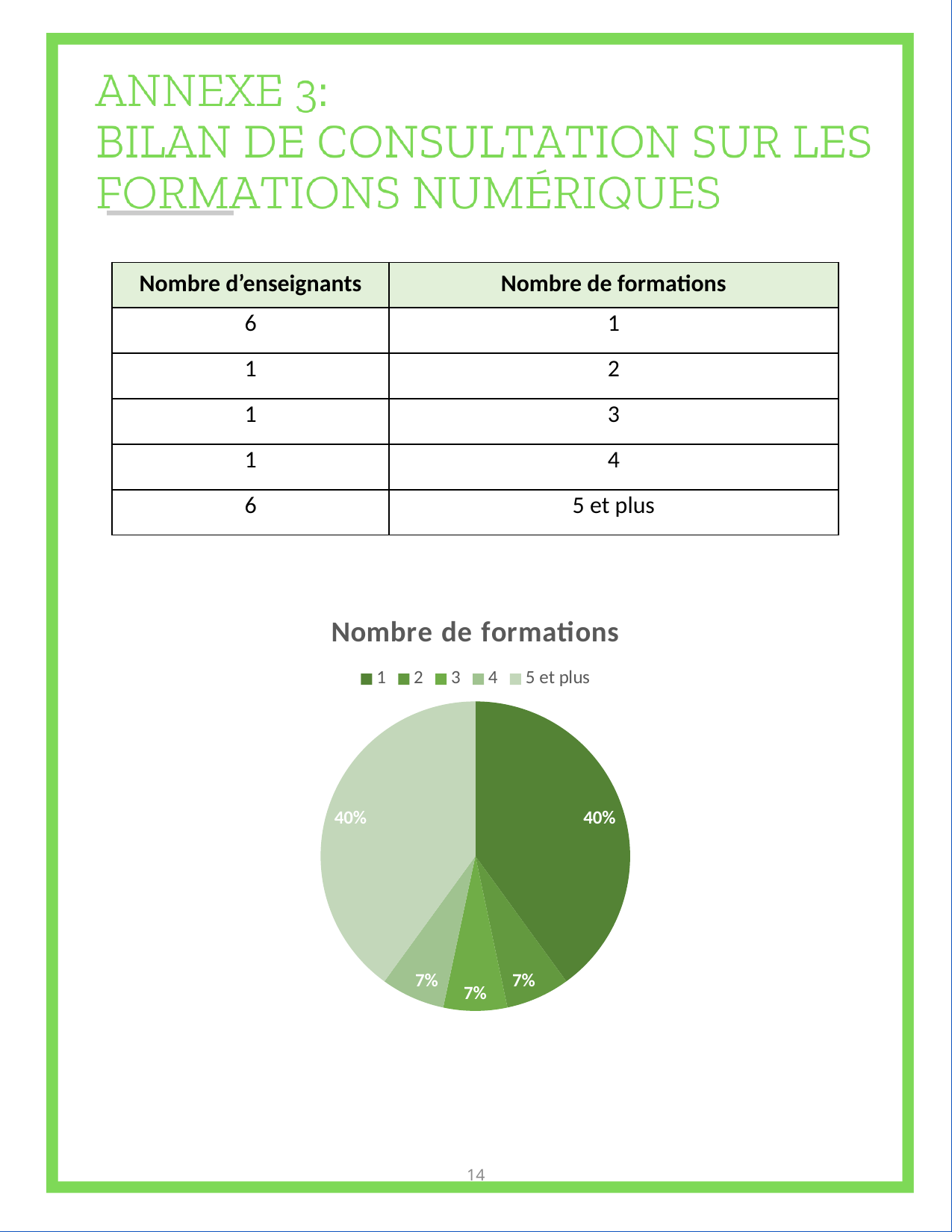
What share of the pie does the slice for "3" represent? 7% Which slice is larger, "1" or "2"? 1 What share of the pie does the slice for "2" represent? 7% What share of the pie does the slice for "1" represent? 40% What type of chart is shown on the slide? pie chart How many entries does the legend of the pie chart list? 5 How many slices does the pie chart have? 5 Which legend entry is shown in the darkest green in the pie chart? 1 What is the difference in percentage points between the slice for "5 et plus" and the slice for "4"? 33% What is the title of the pie chart? Nombre de formations